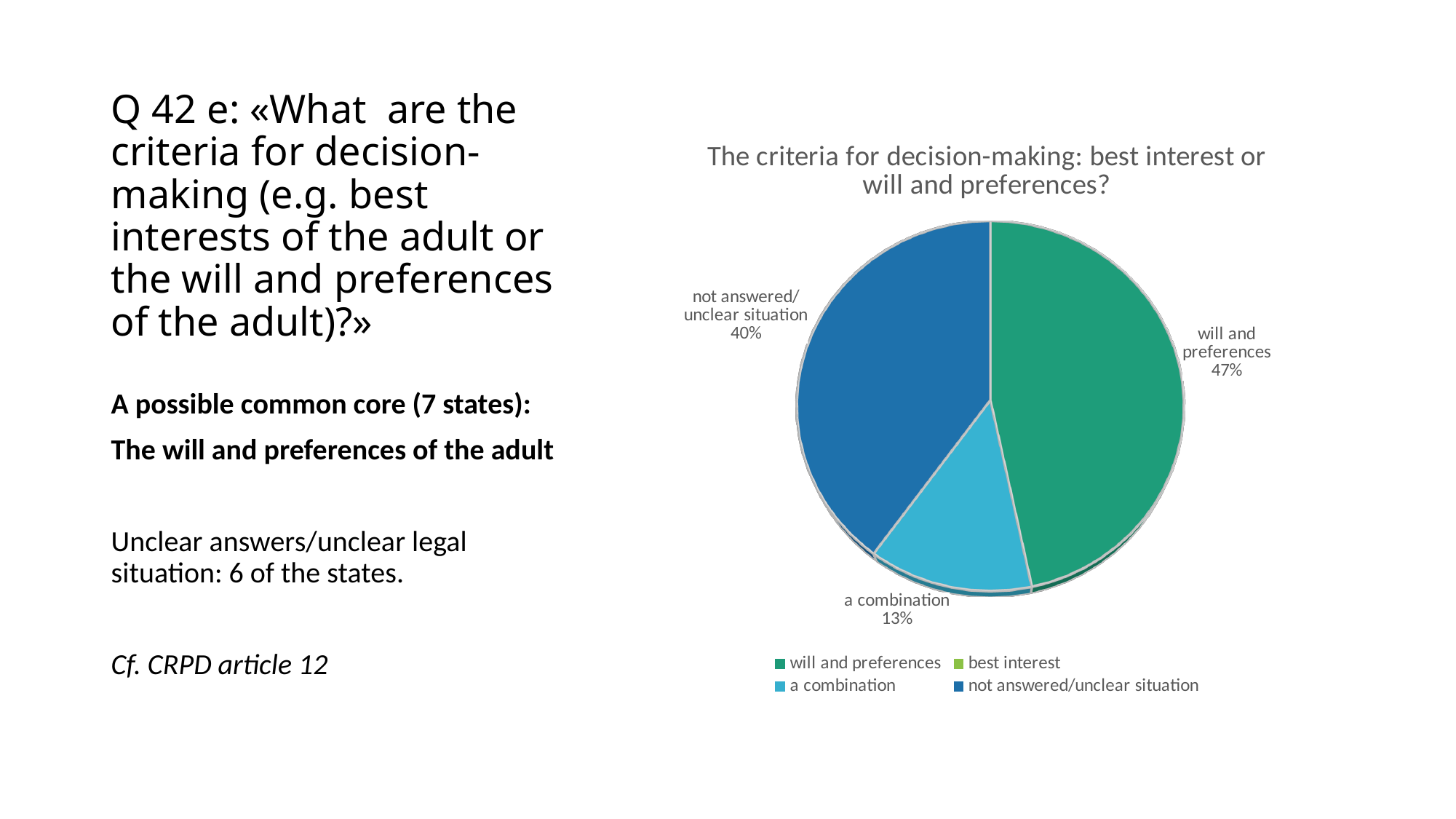
What kind of chart is shown on the slide? pie chart What is the title of the chart? The criteria for decision-making: best interest or will and preferences? What share of the pie does "not answered/unclear situation" represent? 40% What share of the pie does "a combination" represent? 13% Which category has the largest slice of the pie? will and preferences What is the difference in percentage points between "will and preferences" and "not answered/unclear situation"? 7 Which labelled slice of the pie is the smallest? a combination Which legend entry does not appear as a visible slice in the pie? best interest What share of the pie does "will and preferences" represent? 47% How many entries does the chart legend list? 4 What is the difference in percentage points between "not answered/unclear situation" and "a combination"? 27 Which is larger: the share for "will and preferences" or the share for "a combination"? will and preferences